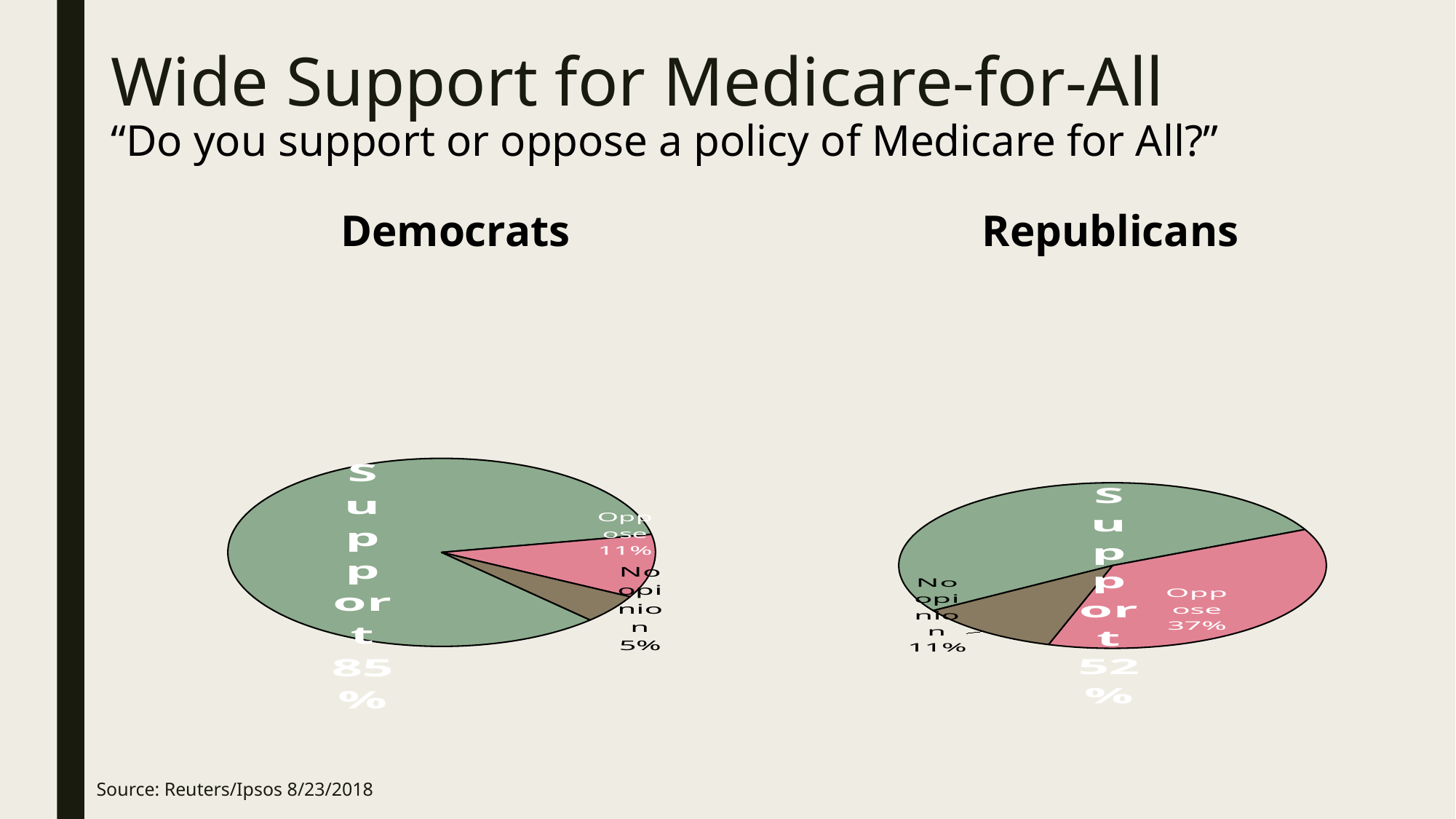
What is the difference between the Support percentage in the Democrats chart and the Support percentage in the Republicans chart? 33 percentage points In the Democrats chart, what share of respondents have no opinion? 5% How many slices does the Republicans pie chart have? 3 What type of chart is used for the Democrats data? Pie chart In the Democrats chart, what percentage of respondents support Medicare for All? 85% In the Republicans chart, which response has the smallest slice? No opinion In the Republicans chart, what share of respondents have no opinion? 11% In the Republicans chart, what is the difference between the Support and Oppose percentages? 15 percentage points In the Republicans chart, what percentage of respondents oppose Medicare for All? 37% In the Republicans chart, what percentage of respondents support Medicare for All? 52% Which is larger: the Oppose share in the Democrats chart or the Oppose share in the Republicans chart? Republicans In the Democrats chart, which response has the largest slice? Support